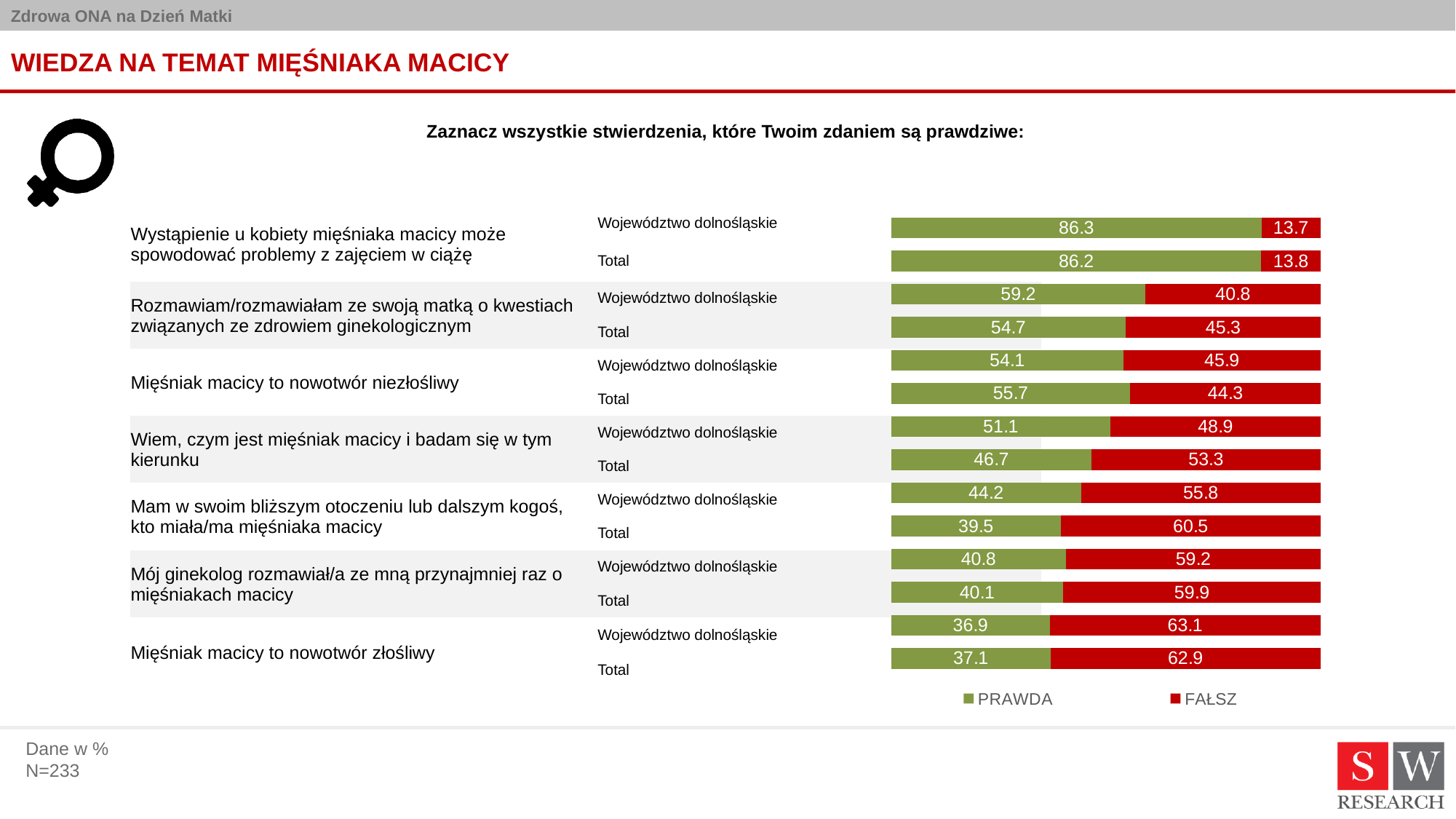
Which statement has the lowest PRAWDA value for 'Total'? Mięśniak macicy to nowotwór złośliwy What is the FAŁSZ value for 'Total' for the statement 'Mięśniak macicy to nowotwór złośliwy'? 62.9 Which colour represents FAŁSZ in the chart? Red How many statements are shown in the chart? 7 What is the difference between the PRAWDA values for 'Województwo dolnośląskie' and 'Total' for the statement 'Wiem, czym jest mięśniak macicy i badam się w tym kierunku'? 4.4 What kind of chart is shown on the slide? Stacked bar chart What is the PRAWDA value for 'Total' for the statement 'Rozmawiam/rozmawiałam ze swoją matką o kwestiach związanych ze zdrowiem ginekologicznym'? 54.7 What is the PRAWDA value for 'Województwo dolnośląskie' for the statement 'Wystąpienie u kobiety mięśniaka macicy może spowodować problemy z zajęciem w ciążę'? 86.3 What is the total of the stacked bar for 'Total' for the statement 'Mam w swoim bliższym otoczeniu lub dalszym kogoś, kto miała/ma mięśniaka macicy'? 100 How many series does the legend list? 2 For the statement 'Mięśniak macicy to nowotwór niezłośliwy', which is larger: the PRAWDA value for 'Województwo dolnośląskie' or for 'Total'? Total Which statement has the highest PRAWDA value for 'Województwo dolnośląskie'? Wystąpienie u kobiety mięśniaka macicy może spowodować problemy z zajęciem w ciążę